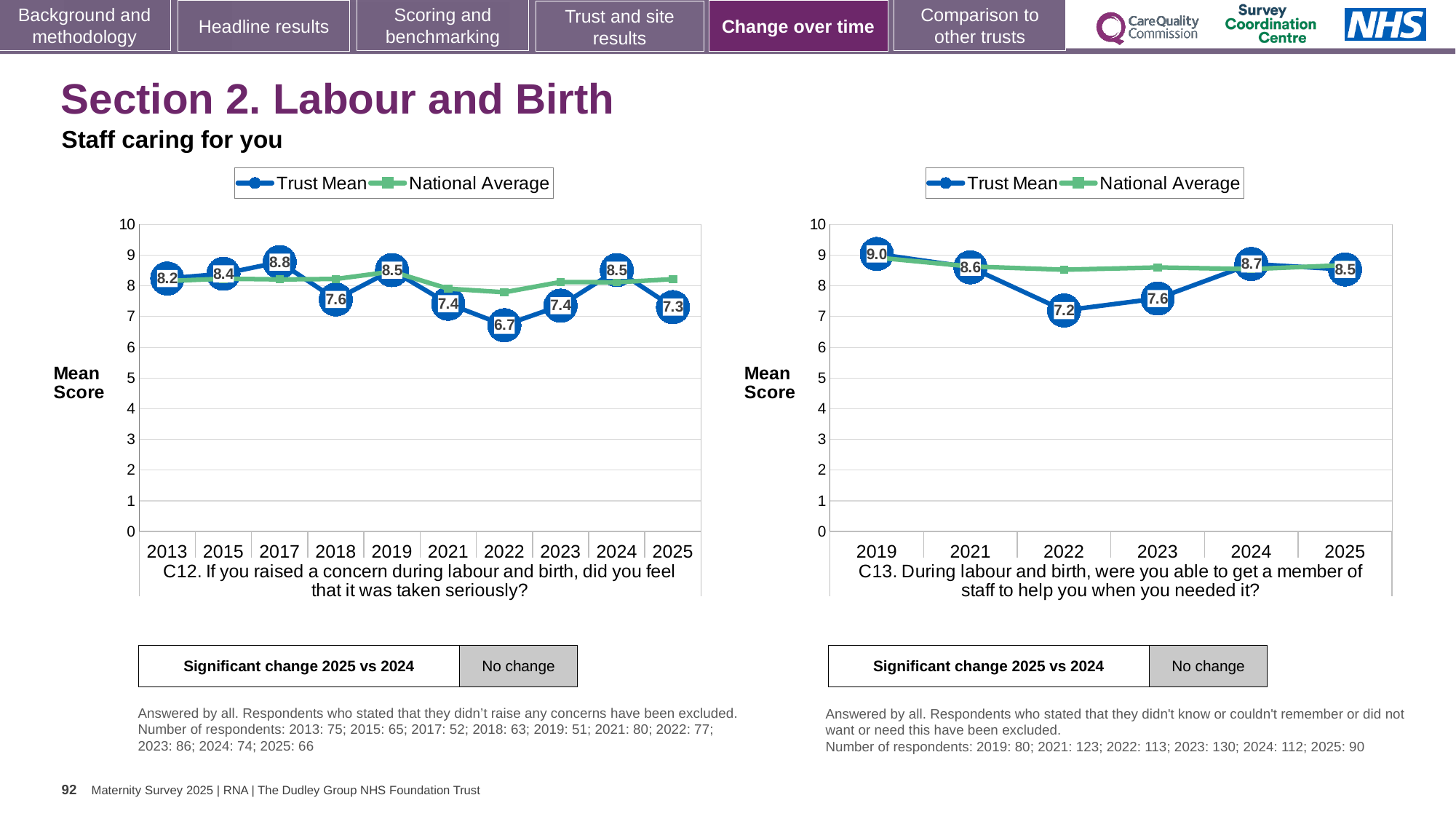
In the C12 chart, what is the difference between the Trust Mean for 2024 and 2025? 1.2 In the C13 chart, which year has the lowest Trust Mean? 2022 In the C12 chart, what is the Trust Mean for 2022? 6.7 In the C13 chart, is the Trust Mean for 2024 or 2025 larger? 2024 In the C13 chart, what is the Trust Mean for 2019? 9.0 In the C12 chart, which year has the lowest Trust Mean? 2022 In the C13 chart, what is the difference between the Trust Mean for 2019 and 2022? 1.8 In the C12 chart, which year has the highest Trust Mean? 2017 In the C12 chart, what is the Trust Mean for 2025? 7.3 In the C12 chart, how many years are plotted on the x axis? 10 In the C13 chart, is the National Average for 2022 greater or less than 8? greater How many series does the legend of the C13 chart list? 2